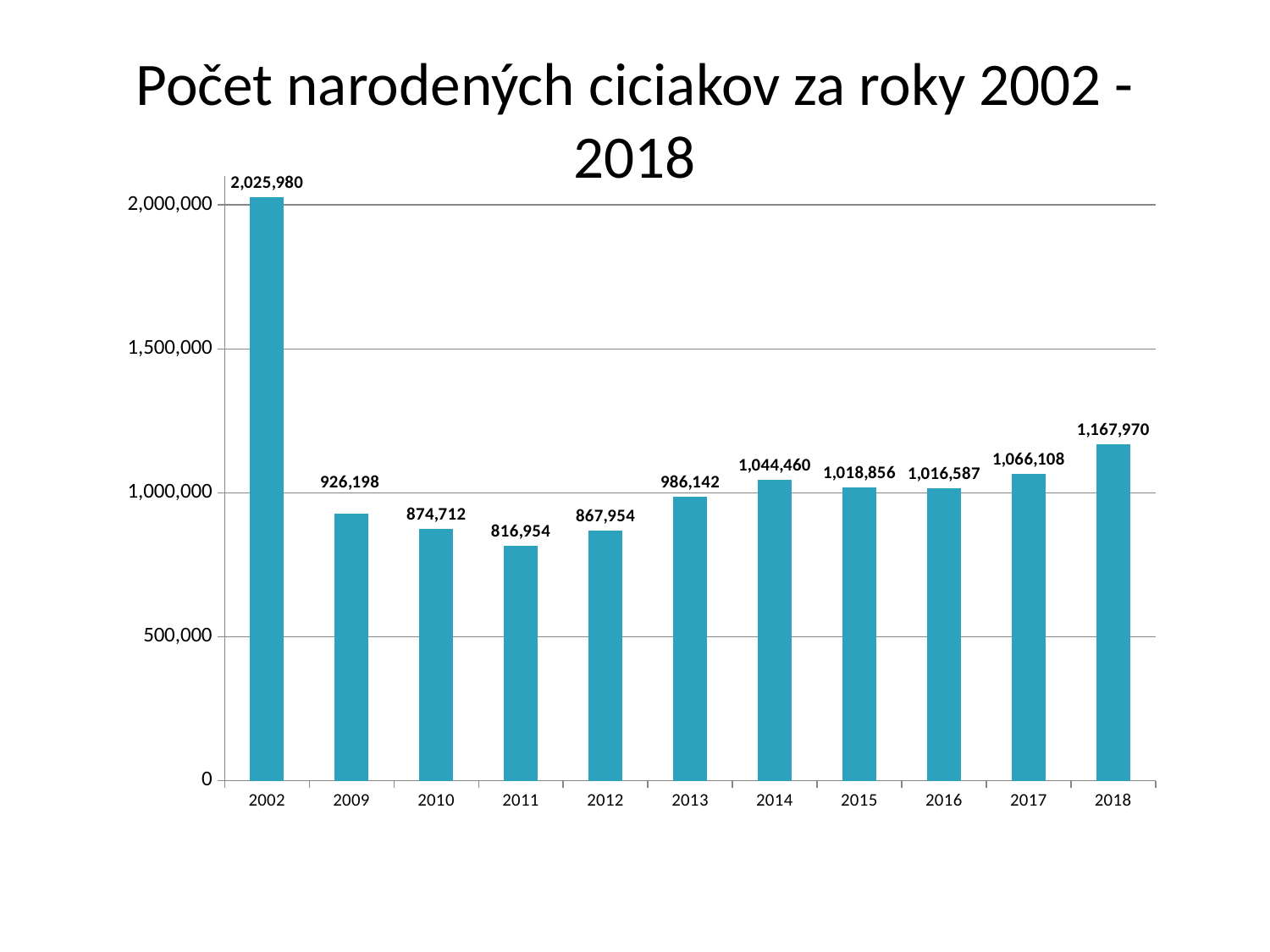
Which year has the lowest value? 2011 What is the difference between the values for 2002 and 2018? 858,010 What is the value for 2002? 2,025,980 How many years are shown on the x axis? 11 What is the difference between the values for 2018 and 2017? 101,862 What is the value for 2018? 1,167,970 Do the values rise or fall from 2009 to 2011? fall What is the value for 2011? 816,954 What kind of chart is shown on the slide? bar chart Is the value for 2009 greater or less than 1,000,000? less Which year has the highest value? 2002 Which is larger, the value for 2014 or the value for 2013? 2014